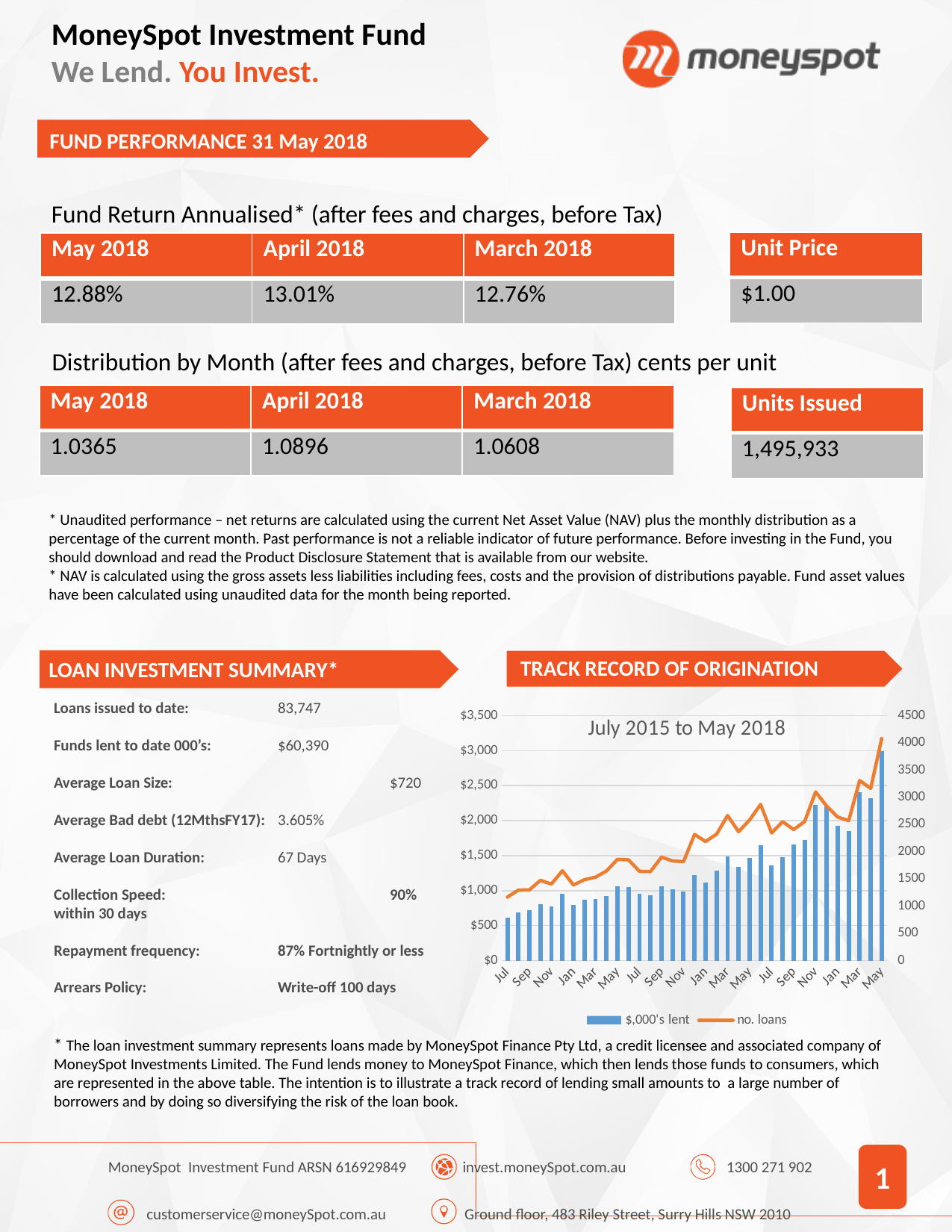
What is the title printed inside the 'Track Record of Origination' chart area? July 2015 to May 2018 In the 'Track Record of Origination' chart, is the $,000's lent value for the final month (May 2018) greater or less than $2,500? greater In the 'Track Record of Origination' chart, which is larger: the $,000's lent value for May 2018 or for Jul 2015? May 2018 In the 'Track Record of Origination' chart, is the no. loans value for the final month (May 2018) greater or less than 3500? greater How many series does the legend of the 'Track Record of Origination' chart list? 2 In the 'Track Record of Origination' chart, which month has the highest value for $,000's lent? May 2018 In the 'Track Record of Origination' chart, is the no. loans value for the first month (Jul 2015) greater or less than 1500? less In the 'Track Record of Origination' chart, does the no. loans line generally rise or fall over the period shown? rise What are the two series named in the legend of the 'Track Record of Origination' chart? $,000's lent and no. loans What kind of chart is shown under 'Track Record of Origination'? A combined bar and line chart In the 'Track Record of Origination' chart, do the $,000's lent values generally rise or fall from July 2015 to May 2018? rise